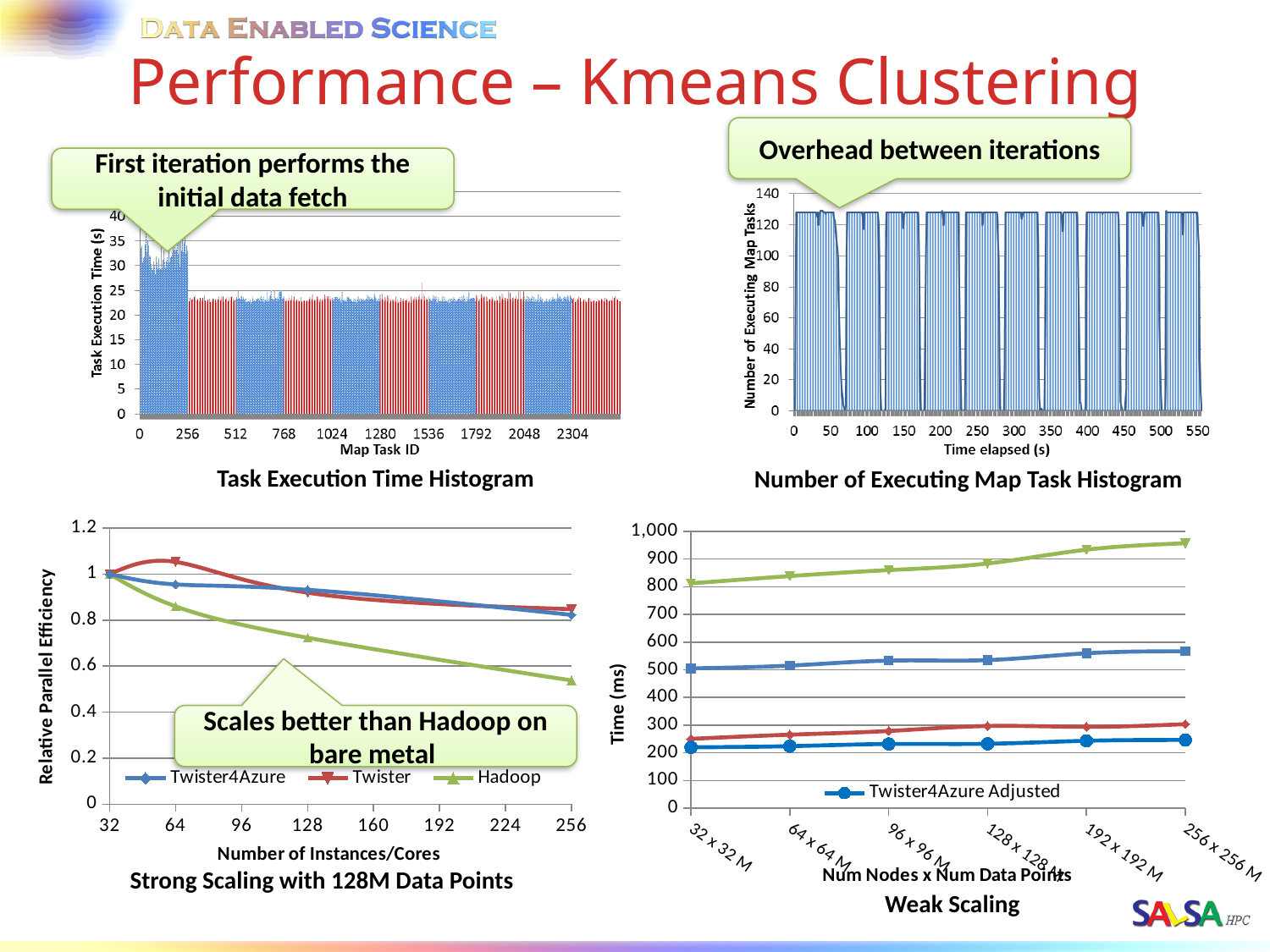
How many series does the legend list in the Strong Scaling with 128M Data Points chart (bottom-left)? 3 In the Number of Executing Map Task Histogram (top-right), is the peak number of executing map tasks greater or less than 100? greater How many categories are shown on the x-axis of the Weak Scaling chart (bottom-right)? 6 In the Strong Scaling with 128M Data Points chart (bottom-left), is the value for Hadoop at 256 instances/cores greater or less than 0.6? less In the Strong Scaling with 128M Data Points chart (bottom-left), at 128 instances/cores, which is larger: Twister4Azure or Hadoop? Twister4Azure In the Task Execution Time Histogram (top-left), what is the x-axis title? Map Task ID In the Strong Scaling with 128M Data Points chart (bottom-left), which series has the lowest relative parallel efficiency at 256 instances/cores? Hadoop In the Weak Scaling chart (bottom-right), is the value for Twister4Azure Adjusted at 32 x 32 M greater or less than 300? less In the Number of Executing Map Task Histogram (top-right), what is the x-axis title? Time elapsed (s) What kind of chart is the Task Execution Time Histogram (top-left)? bar chart In the Strong Scaling with 128M Data Points chart (bottom-left), does the Hadoop line rise or fall as the number of instances/cores increases? fall In the Strong Scaling with 128M Data Points chart (bottom-left), what is the relative parallel efficiency of Twister4Azure at 32 instances/cores? 1